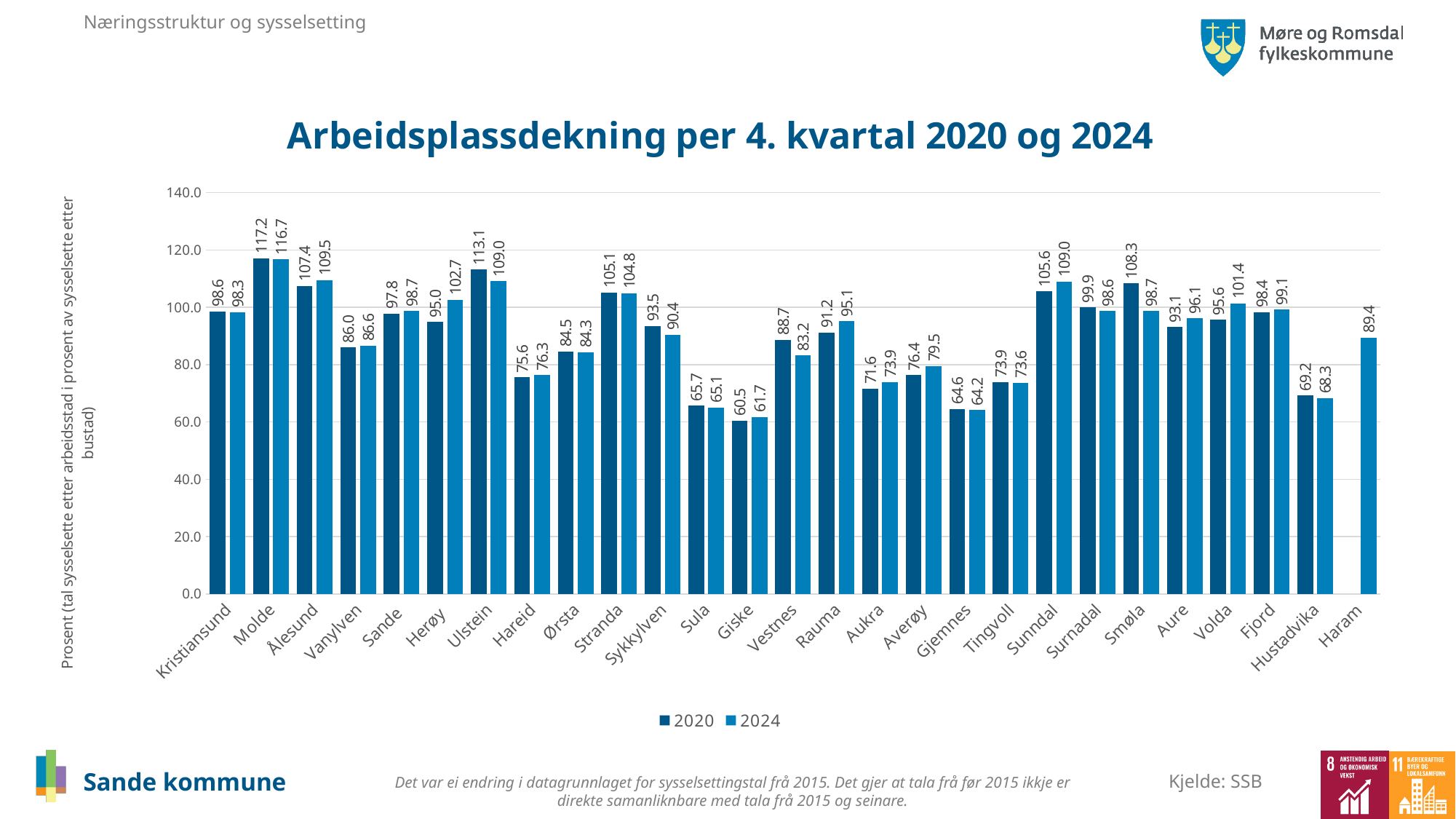
What is the 2024 value for Herøy? 102.7 What kind of chart is shown on the slide? Bar chart How many municipalities are shown on the x axis? 27 What is the difference between the 2020 and 2024 values for Smøla? 9.6 Is the 2020 value for Sunndal greater or less than 100? greater Which municipality has the lowest 2024 value? Giske What is the difference between the 2024 and 2020 values for Herøy? 7.7 How many series does the legend list? 2 Which is larger for Ulstein, the 2020 value or the 2024 value? 2020 What is the 2020 value for Sande? 97.8 What is the 2024 value for Haram? 89.4 Which municipality has the highest 2020 value? Molde